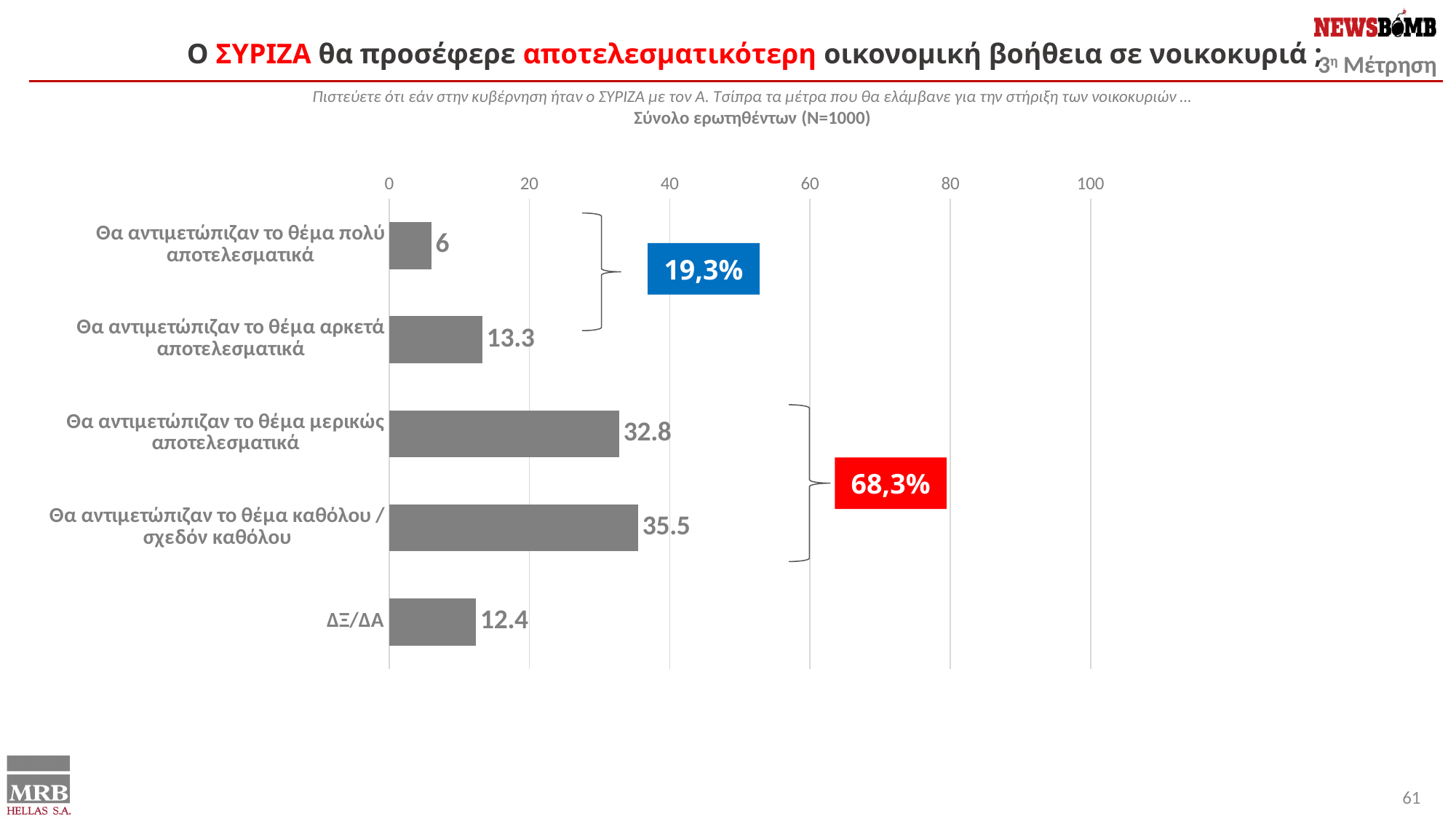
What combined percentage is shown in the red box for the bottom two grouped categories? 68,3% What is the value for ΔΞ/ΔΑ? 12.4 Which category has the highest value? Θα αντιμετώπιζαν το θέμα καθόλου / σχεδόν καθόλου What is the value for "Θα αντιμετώπιζαν το θέμα καθόλου / σχεδόν καθόλου"? 35.5 What is the difference between the values for "καθόλου / σχεδόν καθόλου" and "μερικώς αποτελεσματικά"? 2.7 What is the value for "Θα αντιμετώπιζαν το θέμα μερικώς αποτελεσματικά"? 32.8 What kind of chart is shown on the slide? Bar chart What is the value for "Θα αντιμετώπιζαν το θέμα πολύ αποτελεσματικά"? 6 How many categories are shown in the chart? 5 Which is larger, the value for "αρκετά αποτελεσματικά" or the value for ΔΞ/ΔΑ? αρκετά αποτελεσματικά Which category has the lowest value? Θα αντιμετώπιζαν το θέμα πολύ αποτελεσματικά What is the value for "Θα αντιμετώπιζαν το θέμα αρκετά αποτελεσματικά"? 13.3